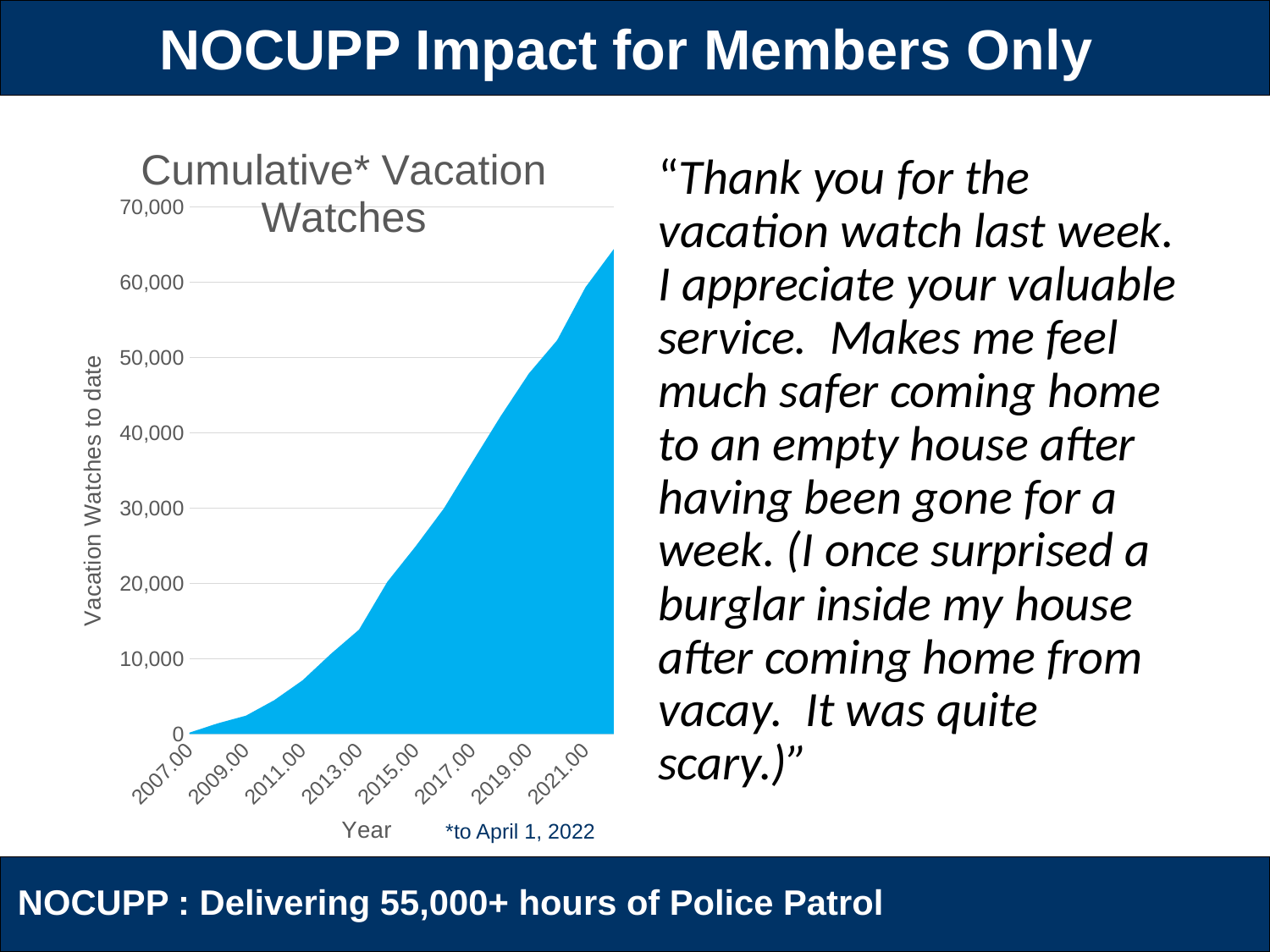
Is the value for 2021.00 greater or less than 50,000? greater Which year shown on the x axis has the lowest value? 2007.00 Is the value for 2015.00 greater or less than 30,000? less What is the label of the vertical axis of the chart? Vacation Watches to date What kind of chart is shown on the slide? area chart How many year labels are shown on the x axis? 8 Which is larger, the value for 2013.00 or the value for 2019.00? 2019.00 Is the value for 2013.00 greater or less than 20,000? less Do the values in the chart rise or fall as the year increases? rise What is the title of the chart? Cumulative* Vacation Watches